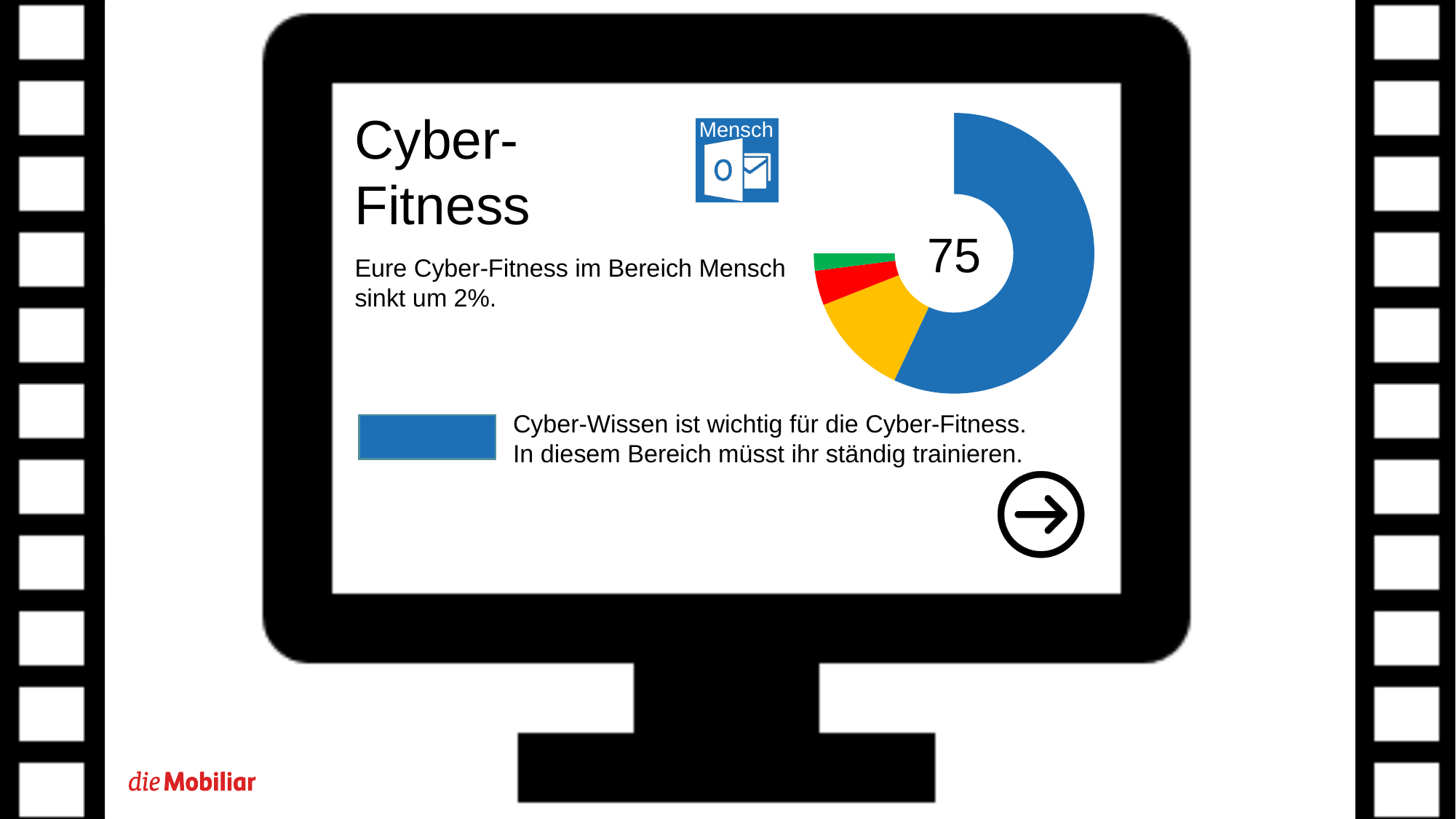
Which slice is larger in the donut chart, the yellow one or the red one? Yellow What number is printed in the centre of the donut chart? 75 Does the blue slice cover more or less than half of the donut chart? More Which slice is larger in the donut chart, the blue one or the yellow one? Blue Which colour slice is the largest in the donut chart? Blue Which colour slice is the smallest in the donut chart? Green How many slices does the donut chart have? 4 Which area (Bereich) does the chart refer to, according to the label above it? Mensch What is the title shown on the slide next to the chart? Cyber-Fitness What kind of chart is shown on the slide? Donut (pie) chart Which slice is larger in the donut chart, the red one or the green one? Red